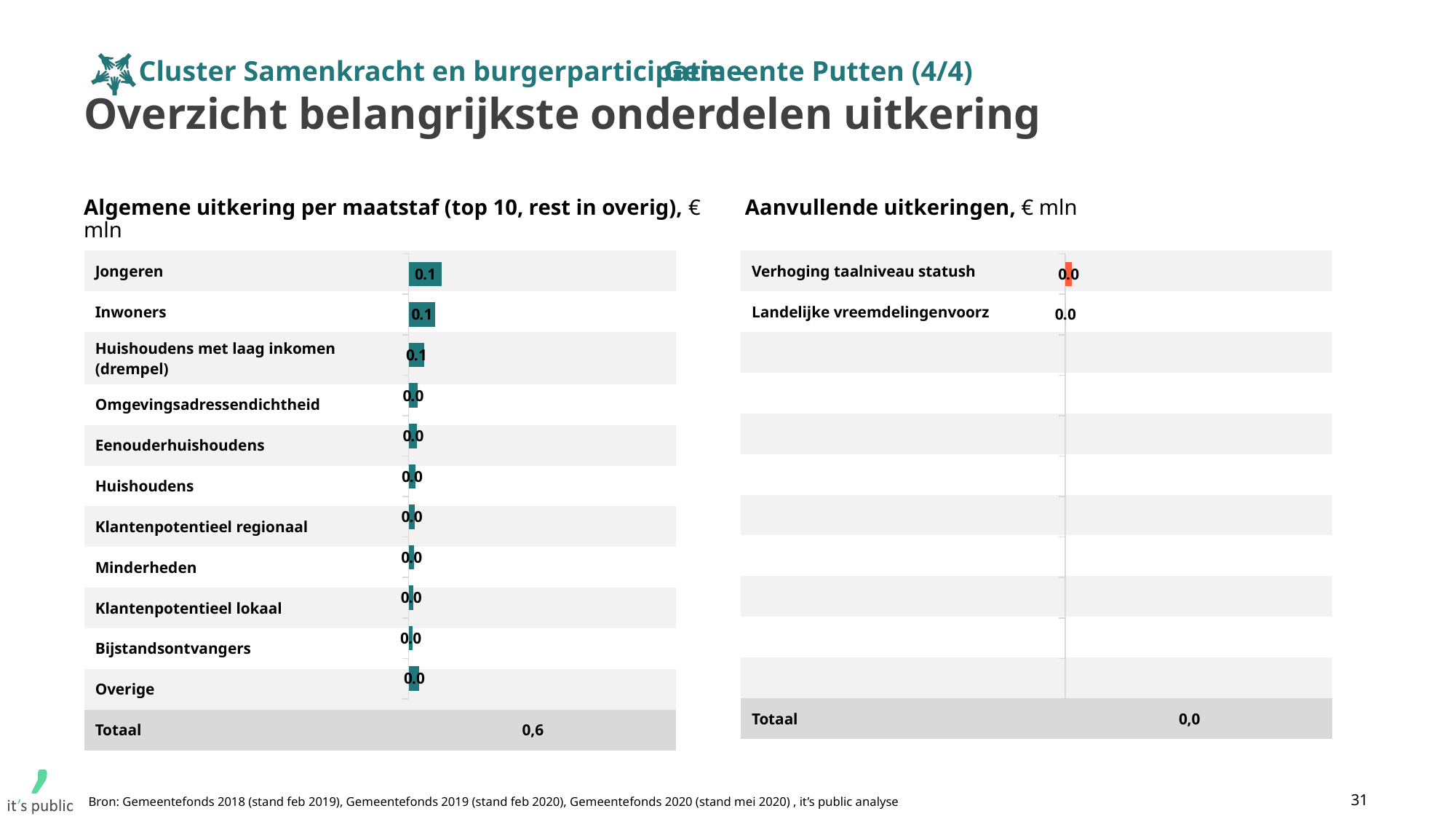
In the chart 'Aanvullende uitkeringen', what is the value for Verhoging taalniveau statush? 0.0 In the chart 'Algemene uitkering per maatstaf', which is larger, the value for Jongeren or the value for Minderheden? Jongeren What kind of chart is 'Algemene uitkering per maatstaf'? bar chart In the chart 'Algemene uitkering per maatstaf', what is the value for Omgevingsadressendichtheid? 0.0 In the chart 'Aanvullende uitkeringen', what is the Totaal shown? 0,0 In the chart 'Aanvullende uitkeringen', how many categories are listed (excluding Totaal)? 2 In the chart 'Algemene uitkering per maatstaf', do the values rise or fall going down the list from Jongeren to Bijstandsontvangers? fall In the chart 'Algemene uitkering per maatstaf', what is the value for Inwoners? 0.1 In the chart 'Algemene uitkering per maatstaf', what is the value for Jongeren? 0.1 In the chart 'Algemene uitkering per maatstaf', what is the Totaal shown? 0,6 In the chart 'Algemene uitkering per maatstaf', how many categories are listed (including Overige, excluding Totaal)? 11 In the chart 'Algemene uitkering per maatstaf', what is the value for Overige? 0.0